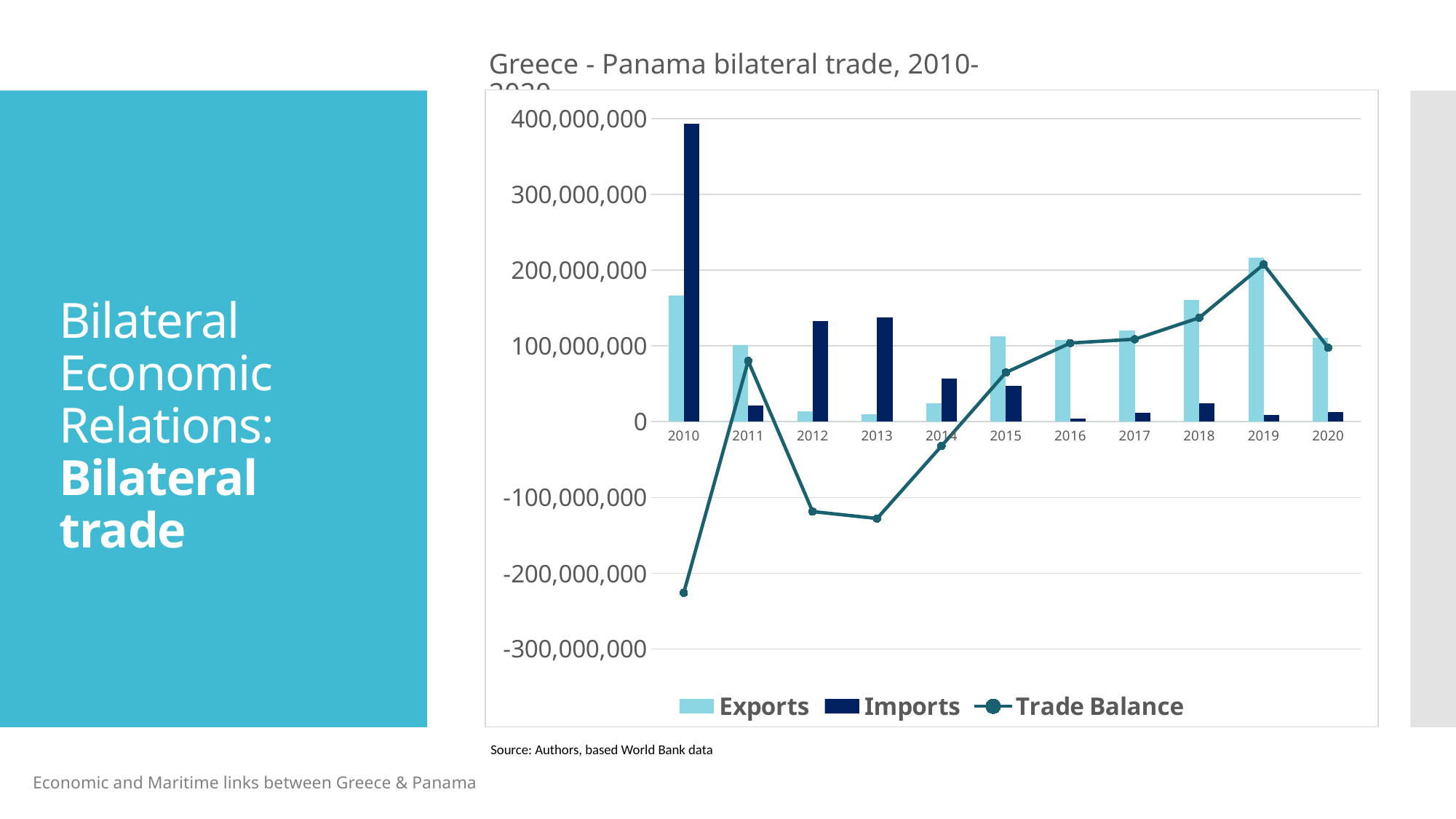
In 2012, which is larger, Exports or Imports? Imports How many series does the legend list? 3 Is the value of Exports in 2019 greater or less than 200,000,000? greater What is the title of the chart? Greece - Panama bilateral trade, 2010-2020 In which year were Exports highest? 2019 In which year was the Trade Balance highest? 2019 In which year was the Trade Balance lowest? 2010 What kind of chart is shown on the slide? A bar chart combined with a line In which year were Imports highest? 2010 How many years are shown on the x axis? 11 Is the value of Imports in 2010 greater or less than 300,000,000? greater Does the Trade Balance line rise or fall between 2013 and 2019? rise